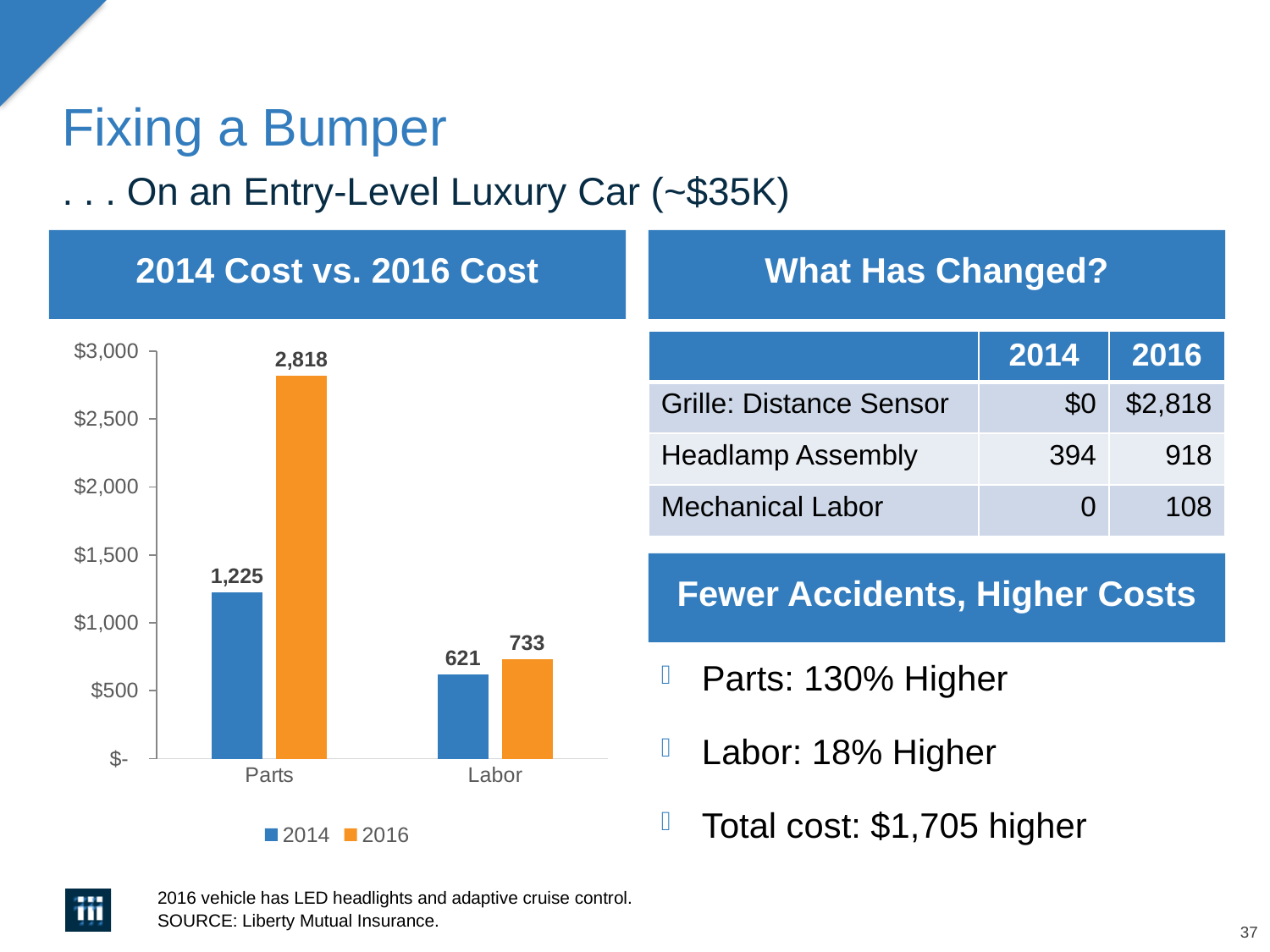
How many series does the legend list? 2 What kind of chart is shown? bar chart Which category has the highest 2016 value? Parts Is the 2016 value for Parts greater or less than $2,500? greater Which is larger, the 2014 value for Parts or the 2016 value for Labor? 2014 value for Parts How many categories are shown on the x axis? 2 What is the 2016 value for Labor? 733 What is the 2014 value for Labor? 621 What is the difference between the 2016 and 2014 values for Parts? 1,593 Which category has the lowest 2014 value? Labor What is the 2016 value for Parts? 2,818 What is the 2014 value for Parts? 1,225